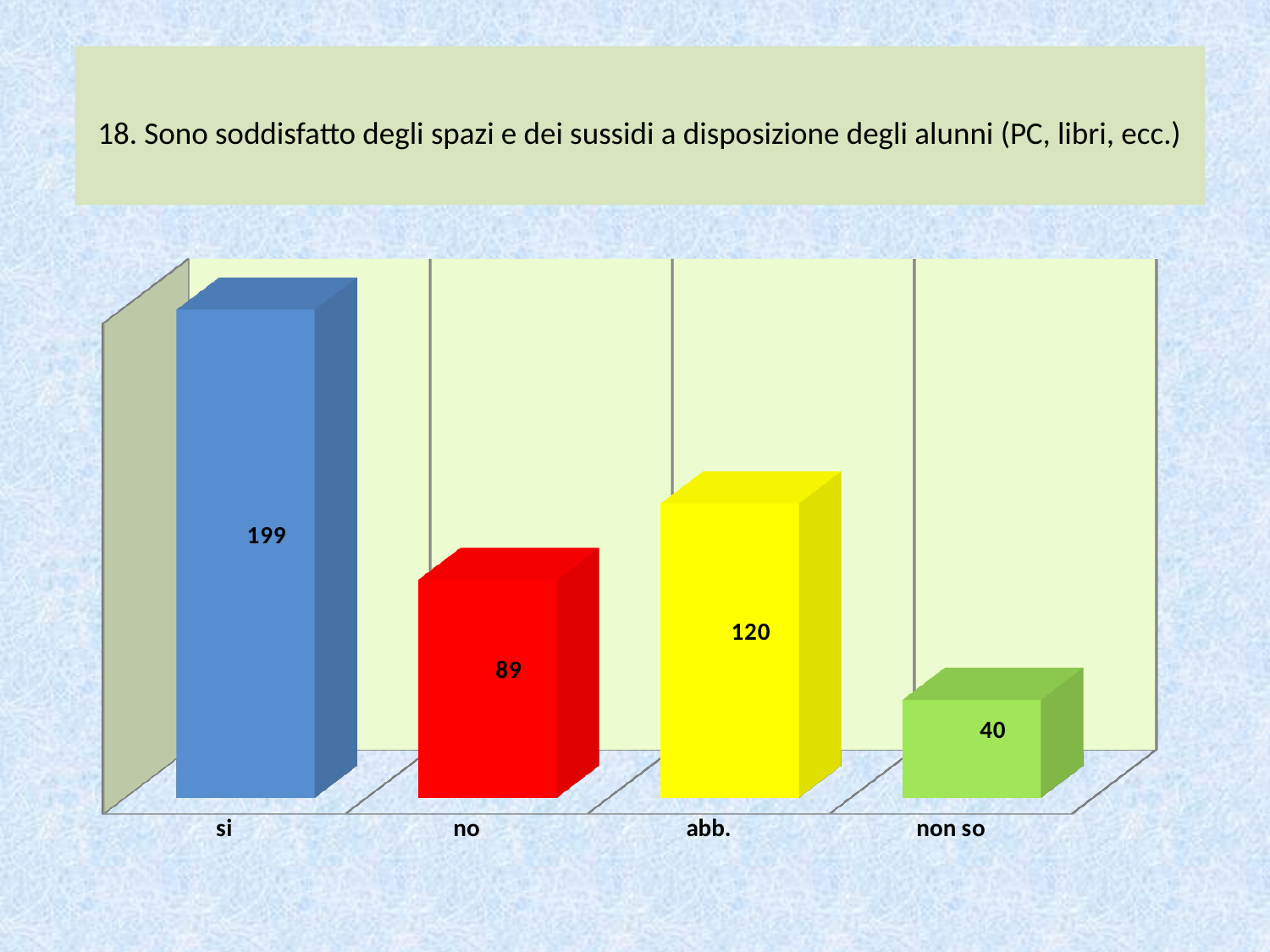
What is the difference between the values for "abb." and "non so"? 80 What colour is the bar for "no"? red What is the value for "non so"? 40 Which is larger, the value for "no" or the value for "abb."? abb. What kind of chart is shown on the slide? bar chart What is the value for "si"? 199 What is the difference between the values for "si" and "no"? 110 What is the value for "no"? 89 What is the value for "abb."? 120 Which category has the lowest value? non so Which category has the highest value? si How many categories are shown on the x axis? 4